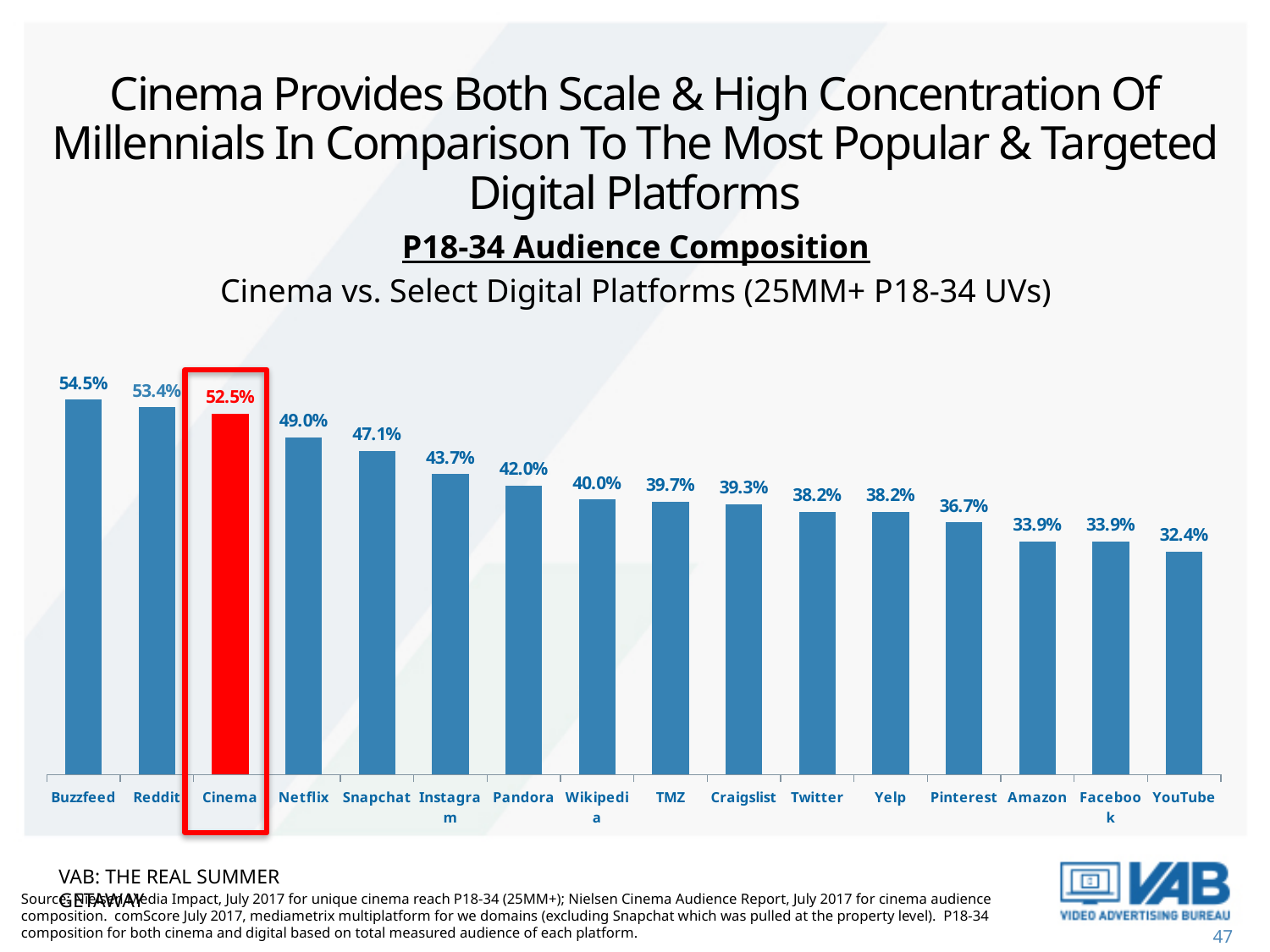
What is the P18-34 audience composition value for Cinema? 52.5% Which platform has the lowest P18-34 audience composition? YouTube How many platforms are shown in the chart? 16 What is the value shown for Snapchat? 47.1% What type of chart is shown on the slide? Bar chart What is the difference between the values for Cinema and Facebook? 18.6% What is the difference between the values for Buzzfeed and Cinema? 2.0% Which has a higher value, Instagram or Pandora? Instagram Which platform has the highest P18-34 audience composition? Buzzfeed What is the value shown for YouTube? 32.4% Which bar is highlighted in red? Cinema What is the value shown for Netflix? 49.0%